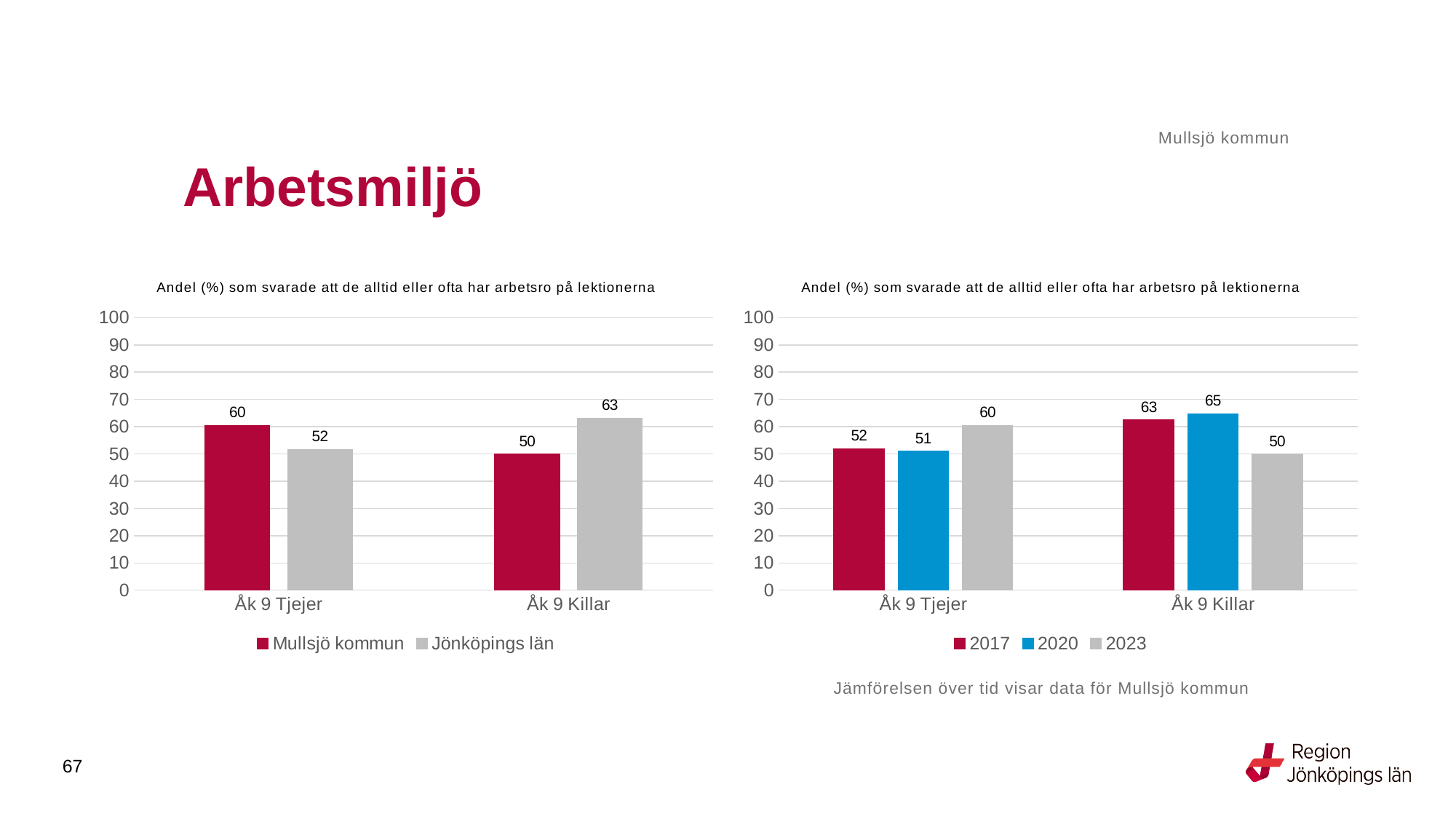
In the left chart, how many series does the legend list? 2 In the right chart, what is the value for 2023 for Åk 9 Tjejer? 60 In the left chart, what is the value for Jönköpings län for Åk 9 Killar? 63 In the right chart, which year has the lowest value for Åk 9 Killar? 2023 In the left chart, what is the value for Mullsjö kommun for Åk 9 Tjejer? 60 In the left chart, which is larger for Åk 9 Tjejer: Mullsjö kommun or Jönköpings län? Mullsjö kommun What kind of chart is the right chart? Bar chart In the right chart, how many series does the legend list? 3 In the left chart, what is the difference between Mullsjö kommun and Jönköpings län for Åk 9 Killar? 13 In the right chart, what is the difference between the 2017 and 2023 values for Åk 9 Tjejer? 8 In the right chart, what is the value for 2020 for Åk 9 Killar? 65 In the right chart, do the values for Åk 9 Tjejer rise or fall from 2020 to 2023? Rise